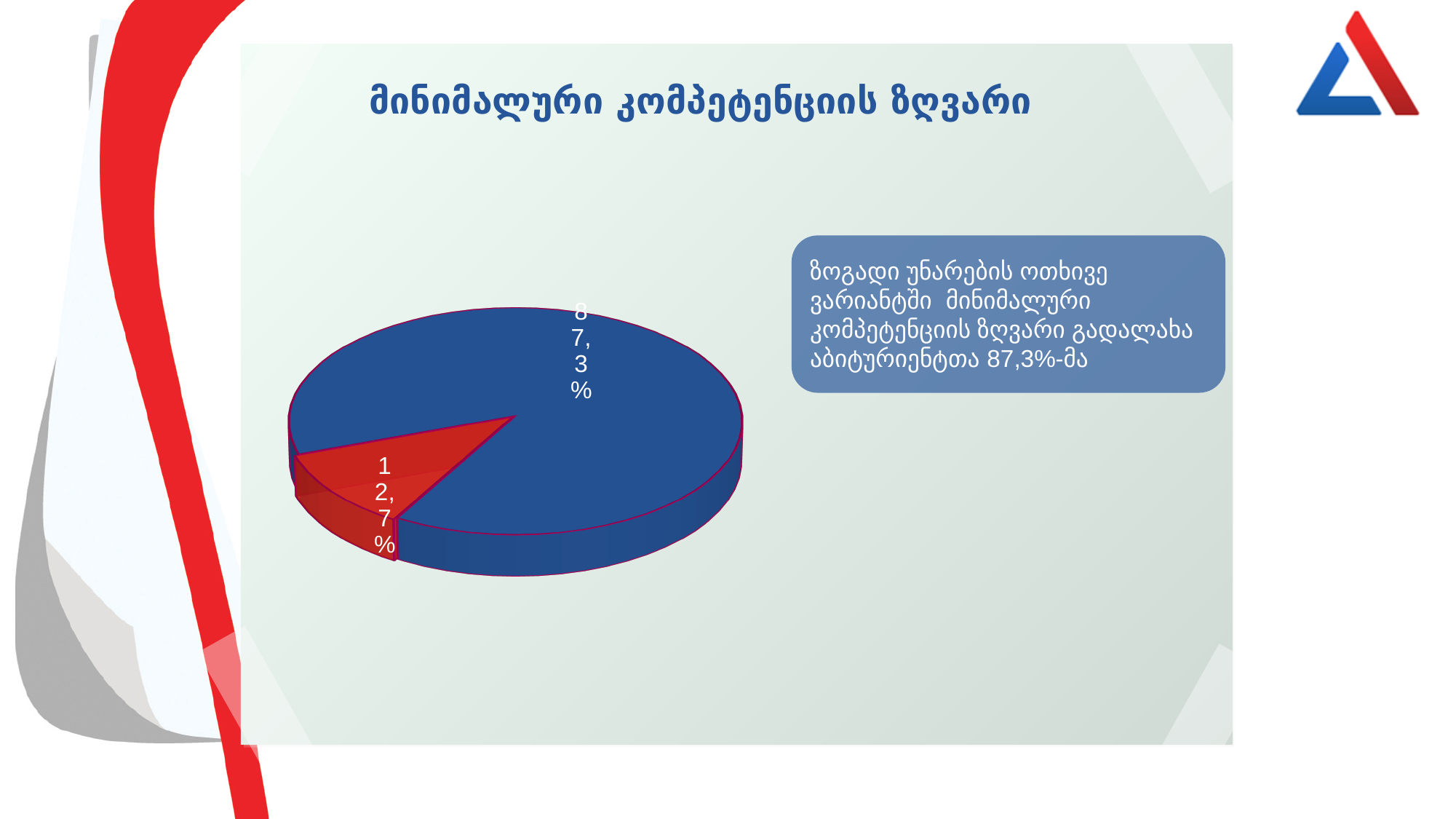
What colour is the slice labelled 87,3%? blue What value is labelled on the blue slice of the pie chart? 87,3% Which slice of the pie chart is the smallest? the red slice (12,7%) Is the value of the red slice greater or less than 50%? less What do the two labelled slice values of the pie chart add up to? 100% What is the title of the slide containing the pie chart? მინიმალური კომპეტენციის ზღვარი Which slice of the pie chart is larger, the blue one or the red one? the blue one How many slices does the pie chart have? 2 What value is labelled on the red slice of the pie chart? 12,7% What is the difference between the blue slice's value and the red slice's value? 74,6% What kind of chart is shown on the slide? pie chart